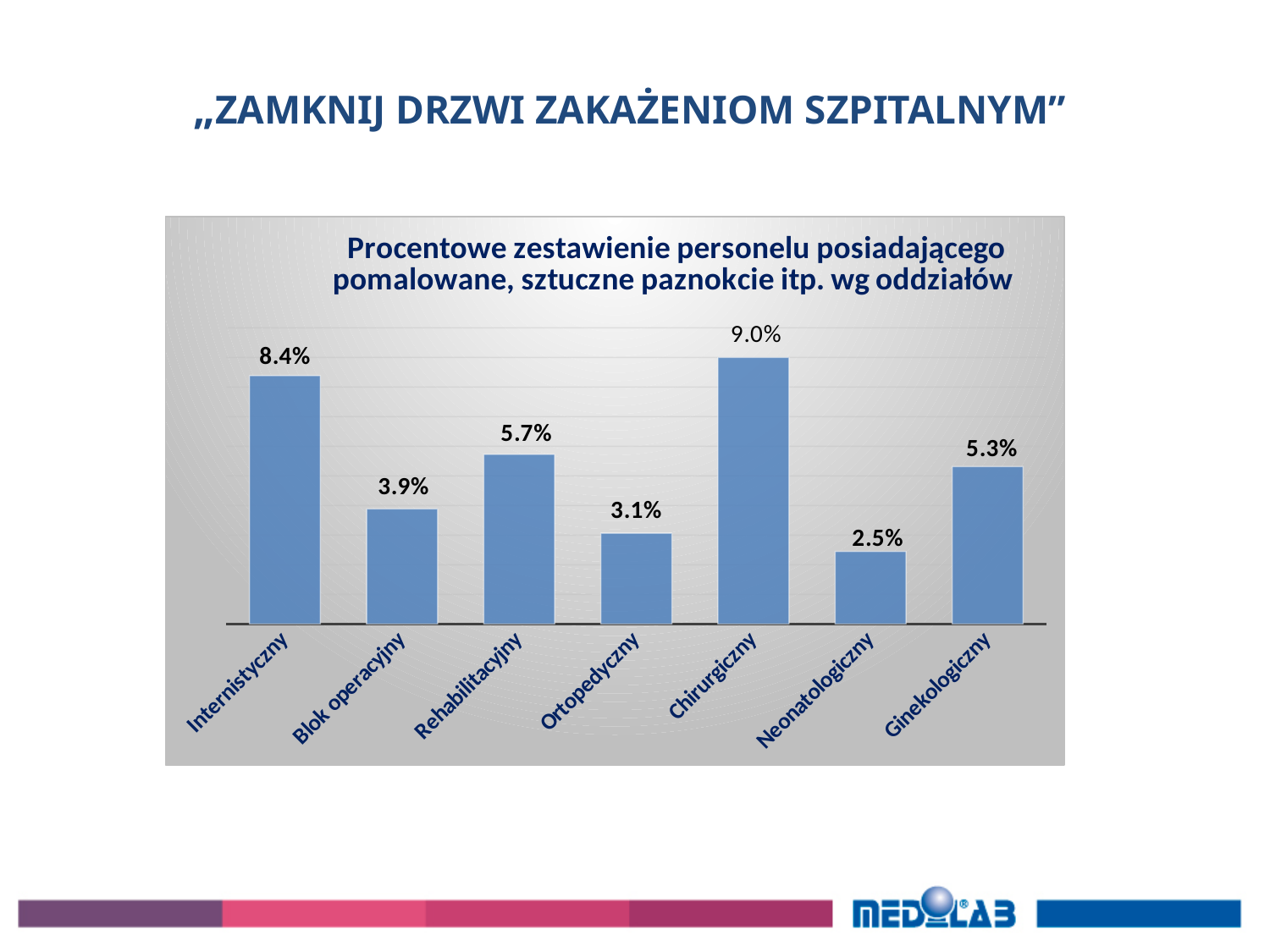
What is the value for Neonatologiczny? 2.5% What is the value for Internistyczny? 8.4% What is the value for Chirurgiczny? 9.0% How many departments are shown on the chart? 7 What is the title of the chart? Procentowe zestawienie personelu posiadającego pomalowane, sztuczne paznokcie itp. wg oddziałów What is the difference between the values for Rehabilitacyjny and Ortopedyczny? 2.6% What kind of chart is shown on the slide? Bar chart Which department has the lowest value? Neonatologiczny Which department has the highest value? Chirurgiczny Which is larger, the value for Ginekologiczny or the value for Blok operacyjny? Ginekologiczny What is the difference between the values for Chirurgiczny and Internistyczny? 0.6% What is the value for Blok operacyjny? 3.9%